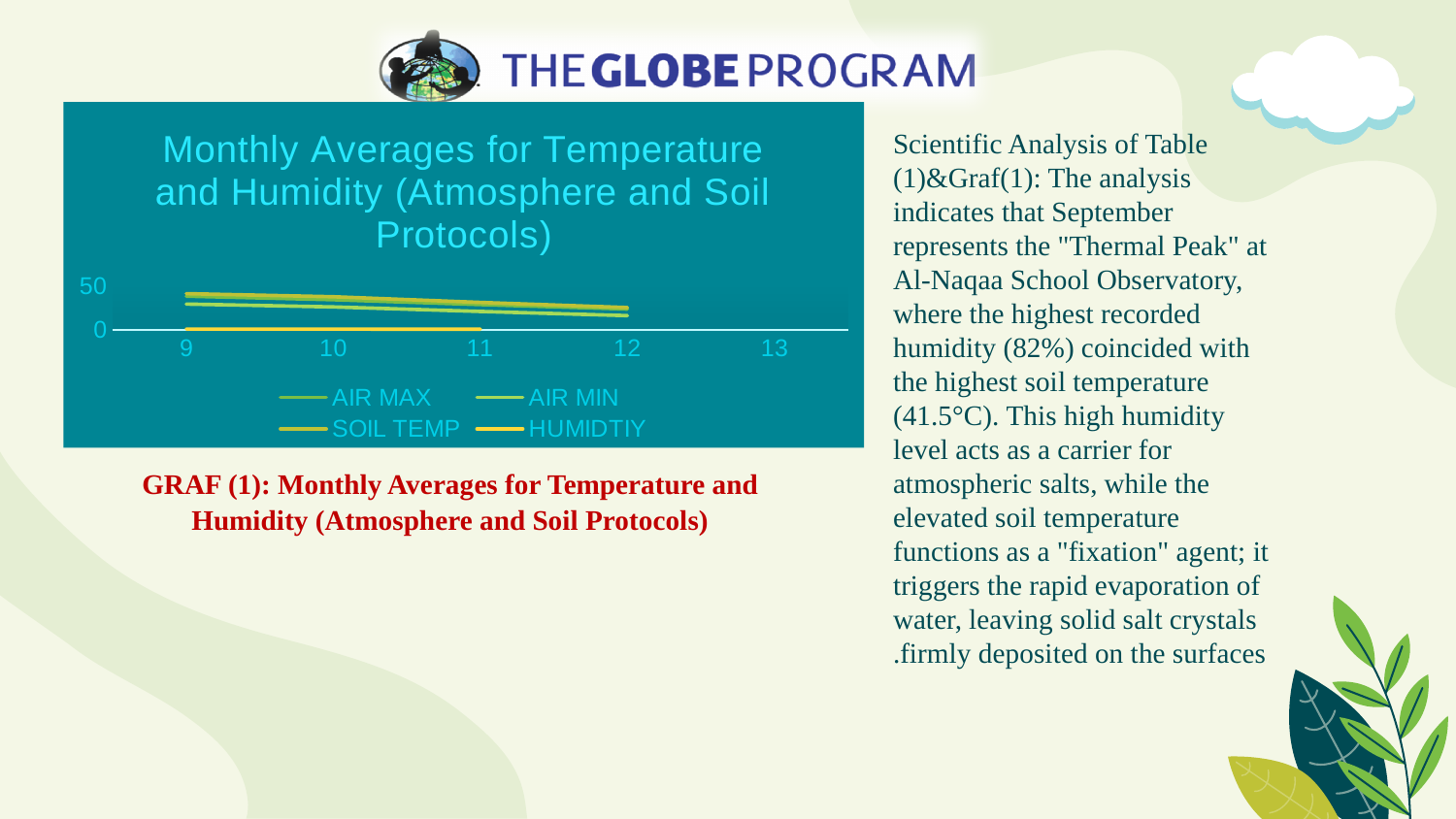
What is the last value labelled on the chart's horizontal axis? 13 How many series does the chart's legend list? 4 What is the title of the chart? Monthly Averages for Temperature and Humidity (Atmosphere and Soil Protocols) What is the first value labelled on the chart's horizontal axis? 9 What kind of chart is shown on the slide? line chart Which series are listed in the chart's legend? AIR MAX, AIR MIN, SOIL TEMP, HUMIDTIY How many tick labels are shown on the chart's horizontal axis? 5 What is the highest value labelled on the chart's vertical axis? 50